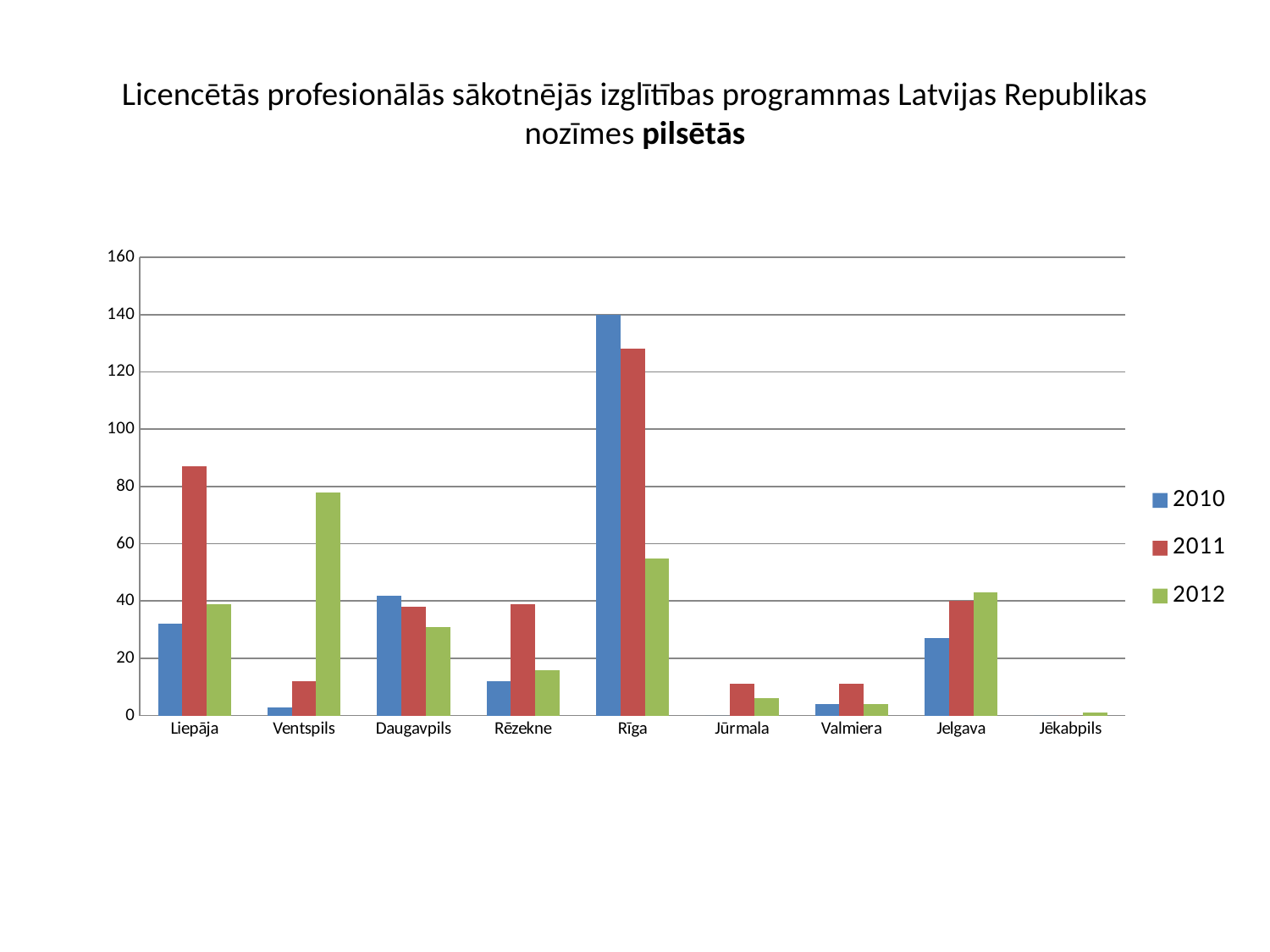
Which city has the tallest bar in the chart? Rīga Which city has the highest value for 2012? Ventspils What kind of chart is shown on the slide? bar chart Is the value for Rīga in 2011 greater or less than 120? greater Is the value for Jūrmala in 2011 greater or less than 20? less For Liepāja, which is larger: the 2011 value or the 2012 value? 2011 How many cities are shown on the x axis of the chart? 9 Is the value for Ventspils in 2012 greater or less than 60? greater Which city has the lowest values overall in the chart? Jēkabpils How many series does the legend list? 3 Which city has the highest value for 2011? Rīga Which years are listed in the chart legend? 2010, 2011, 2012